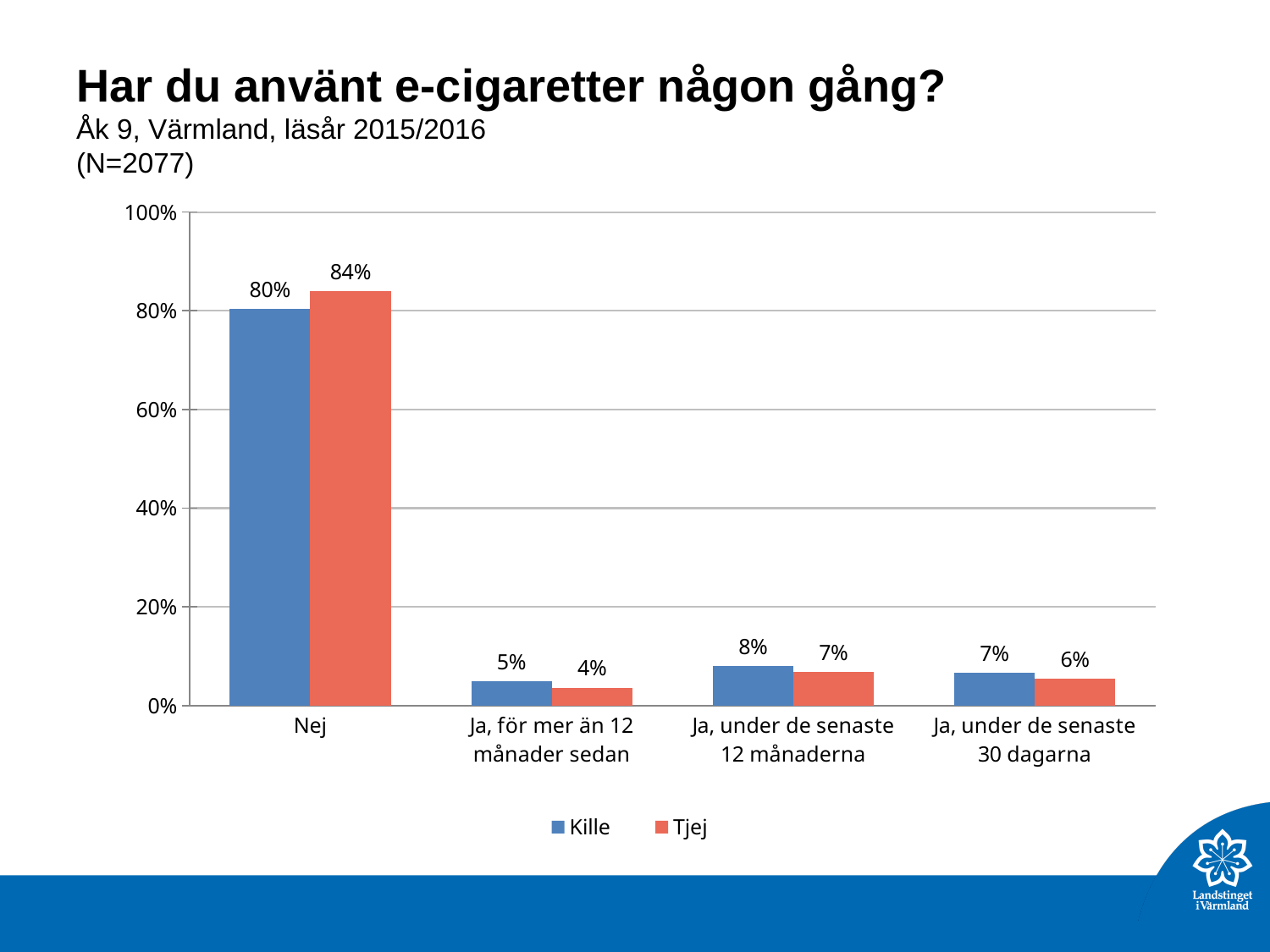
In the 'Ja, under de senaste 30 dagarna' category, which series has the larger value, Kille or Tjej? Kille Which category has the highest value for Tjej? Nej What is the value for Tjej in the 'Ja, för mer än 12 månader sedan' category? 4% What is the difference between the Tjej and Kille values in the Nej category? 4% Which category has the lowest value for Kille? Ja, för mer än 12 månader sedan What is the value for Kille in the Nej category? 80% What is the value for Tjej in the Nej category? 84% How many categories are shown on the x axis? 4 Is the value for Kille in the Nej category greater or less than 60%? greater What is the value for Kille in the 'Ja, under de senaste 12 månaderna' category? 8% What kind of chart is shown on the slide? Bar chart How many series does the legend list? 2